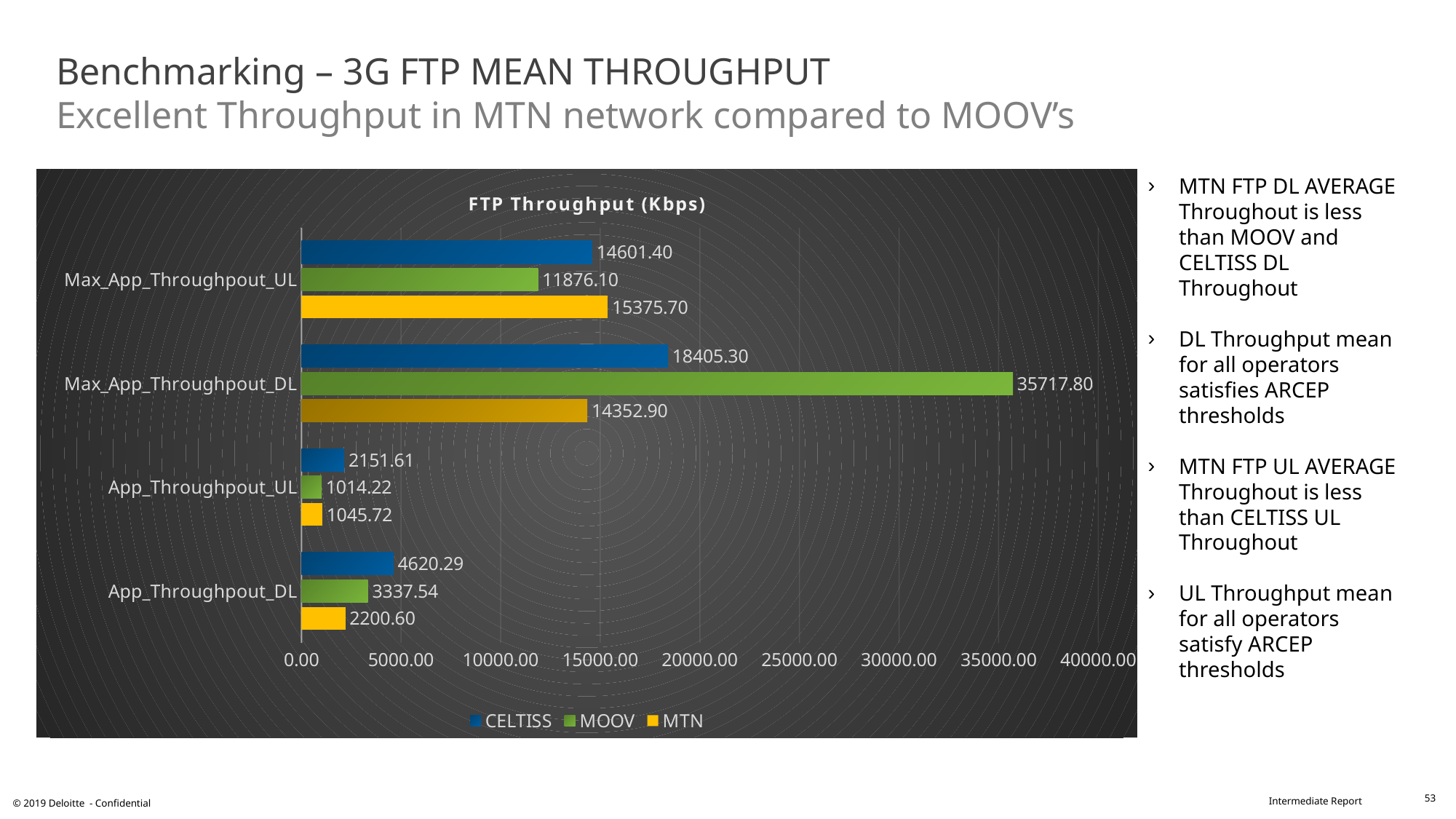
Which series has the lowest value for App_Throughpout_DL? MTN What is the MOOV value for Max_App_Throughpout_DL? 35717.80 What is the CELTISS value for App_Throughpout_UL? 2151.61 How many series does the legend list? 3 What is the MTN value for Max_App_Throughpout_UL? 15375.70 Is the MOOV value for Max_App_Throughpout_DL greater or less than 30000.00? greater Which series has the highest value for Max_App_Throughpout_DL? MOOV What is the title of the chart? FTP Throughput (Kbps) Which is larger for Max_App_Throughpout_UL, the CELTISS value or the MOOV value? CELTISS What is the difference between the CELTISS and MOOV values for App_Throughpout_DL? 1282.75 How many categories are shown on the chart? 4 What kind of chart is shown on the slide? bar chart